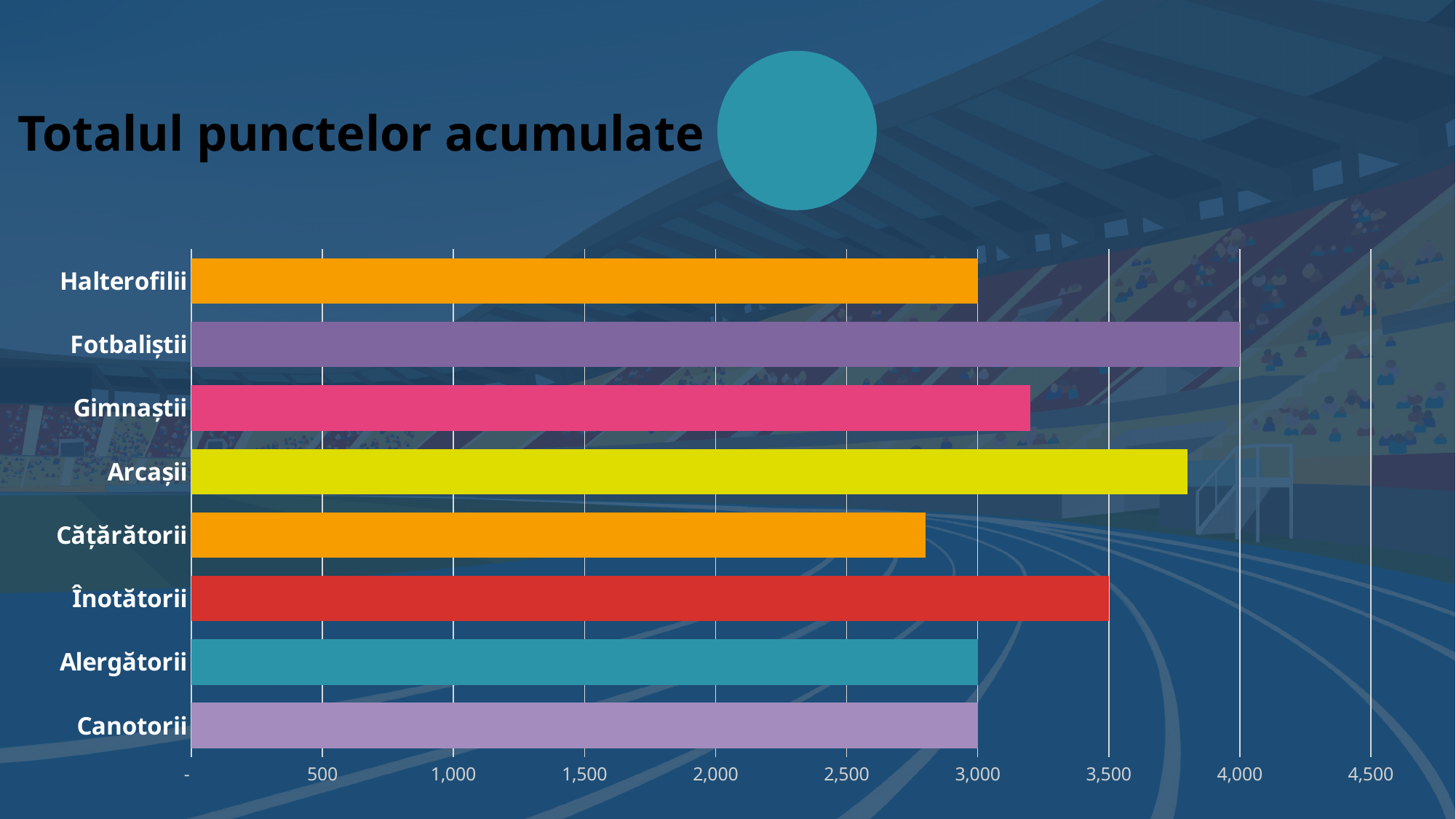
What is the difference between the values for Fotbaliștii and Înotătorii? 500 How many categories are shown in the chart? 8 What is the value for Fotbaliștii? 4,000 What is the title of the chart? Totalul punctelor acumulate What is the value for Canotorii? 3,000 What kind of chart is shown on the slide? bar chart What is the value for Înotătorii? 3,500 Which is larger, the value for Arcașii or the value for Gimnaștii? Arcașii Is the value for Gimnaștii greater or less than 3,000? greater Which category has the lowest value? Cățărătorii Which category has the highest value? Fotbaliștii Is the value for Cățărătorii greater or less than 3,000? less